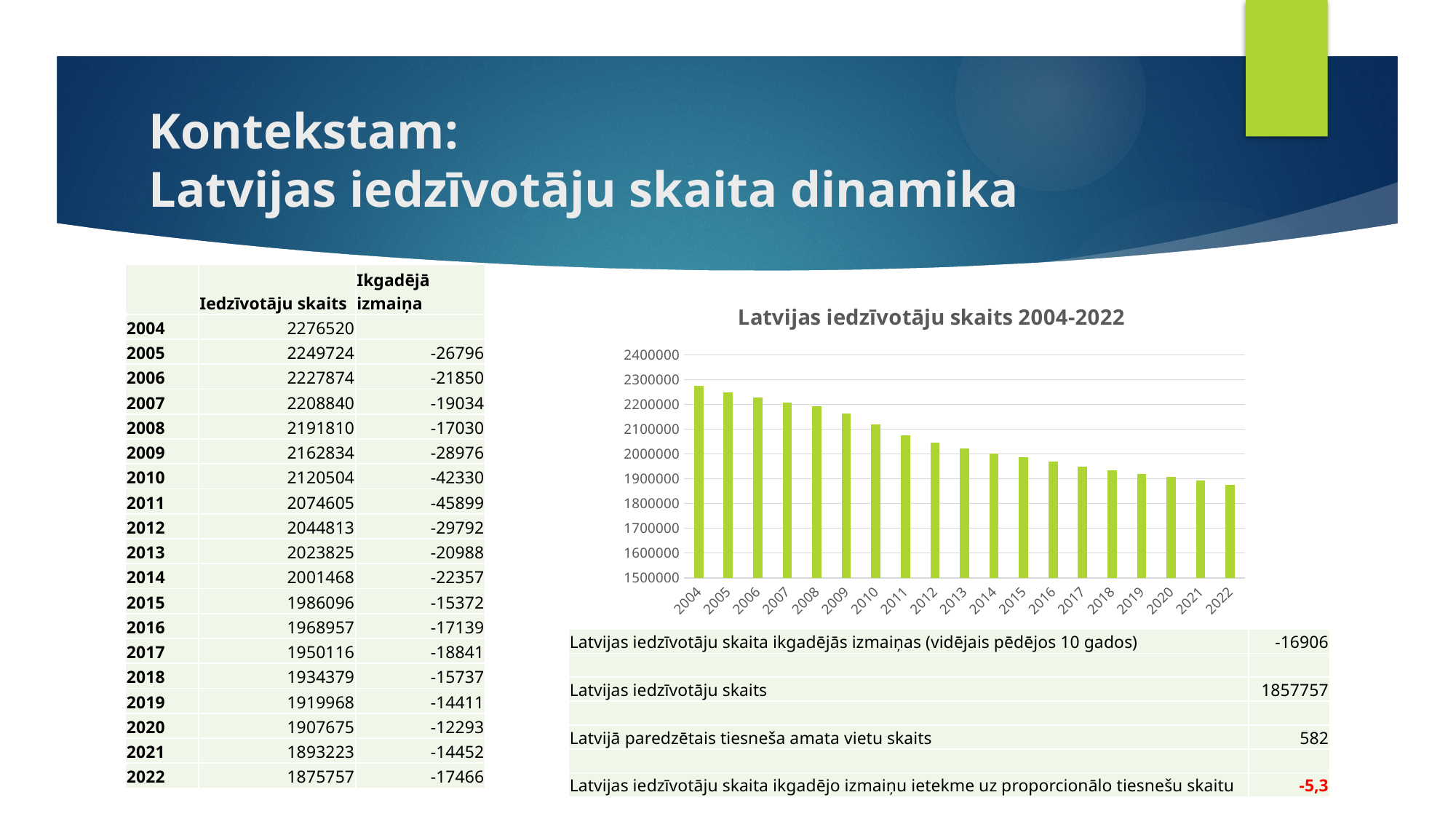
Is the value for 2022 greater or less than 1900000? less According to the table on the slide, what is the population value plotted for 2004? 2276520 Using the table values, what is the difference between the population in 2004 and in 2022? 400763 What type of chart is shown on the slide? bar chart Is the value for 2010 greater or less than 2100000? greater Is the value for 2015 greater or less than 2000000? less Which year has the highest bar in the chart? 2004 Which year has the lowest bar in the chart? 2022 Do the values in the chart rise or fall from 2004 to 2022? fall What is the title of the chart? Latvijas iedzīvotāju skaits 2004-2022 Which bar is taller, 2005 or 2020? 2005 How many bars (years) does the chart show? 19